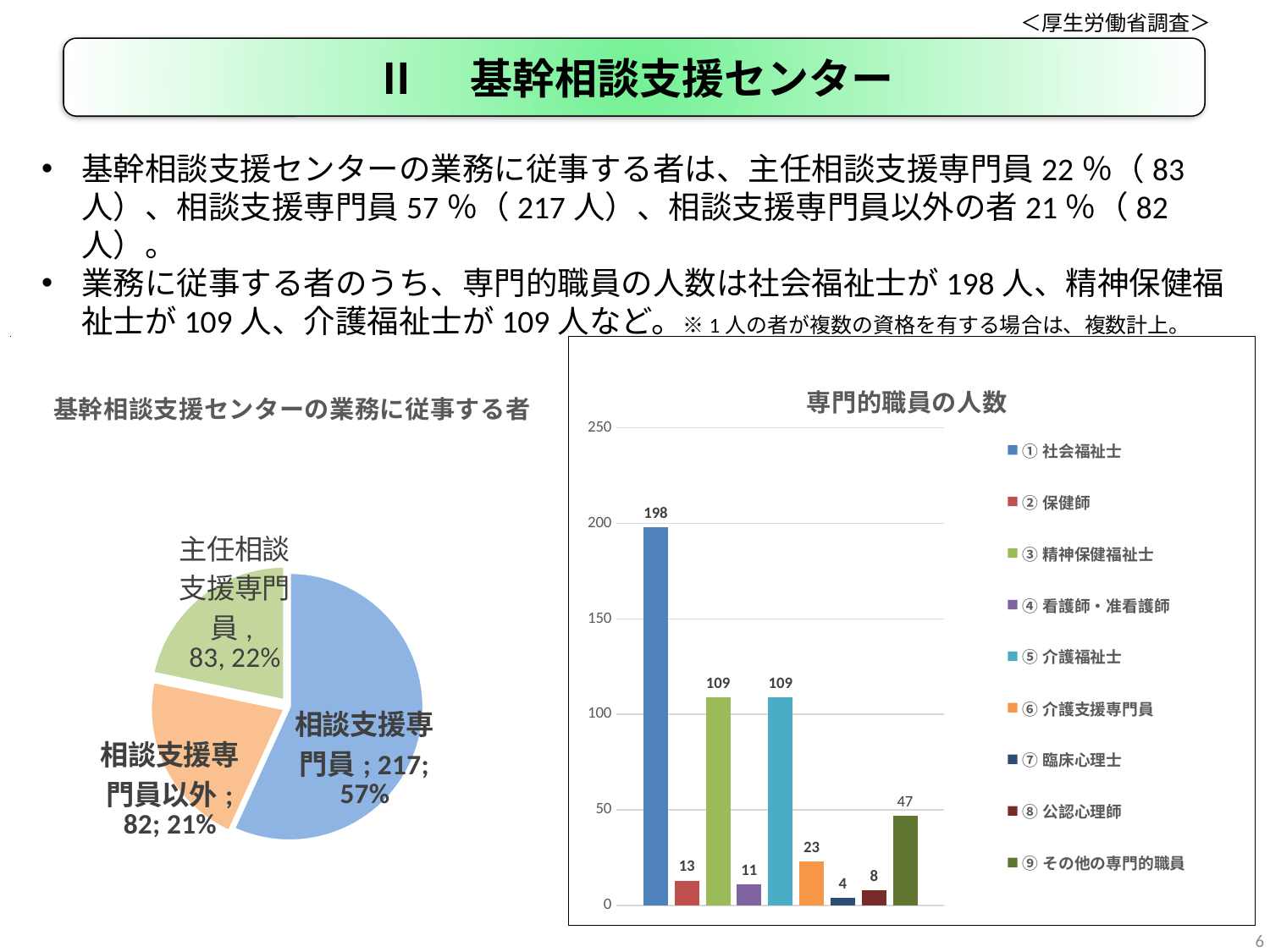
「基幹相談支援センターの業務に従事する者」のグラフはどの種類のグラフですか？ 円グラフ 「専門的職員の人数」のグラフで、介護支援専門員の人数はいくつですか？ 23 「基幹相談支援センターの業務に従事する者」のグラフで、相談支援専門員の人数はいくつですか？ 217 「基幹相談支援センターの業務に従事する者」のグラフで、最も割合が大きい区分はどれですか？ 相談支援専門員 「専門的職員の人数」のグラフで、最も人数が多い職種はどれですか？ 社会福祉士 「専門的職員の人数」のグラフはどの種類のグラフですか？ 棒グラフ 「専門的職員の人数」のグラフで、保健師と看護師・准看護師ではどちらの人数が多いですか？ 保健師 「専門的職員の人数」のグラフで、最も人数が少ない職種はどれですか？ 臨床心理士 「専門的職員の人数」のグラフで、社会福祉士の人数はいくつですか？ 198 「基幹相談支援センターの業務に従事する者」のグラフで、主任相談支援専門員の割合は何％ですか？ 22% 「専門的職員の人数」のグラフで、凡例にはいくつの職種が示されていますか？ 9 「専門的職員の人数」のグラフで、社会福祉士と精神保健福祉士の人数の差はいくつですか？ 89